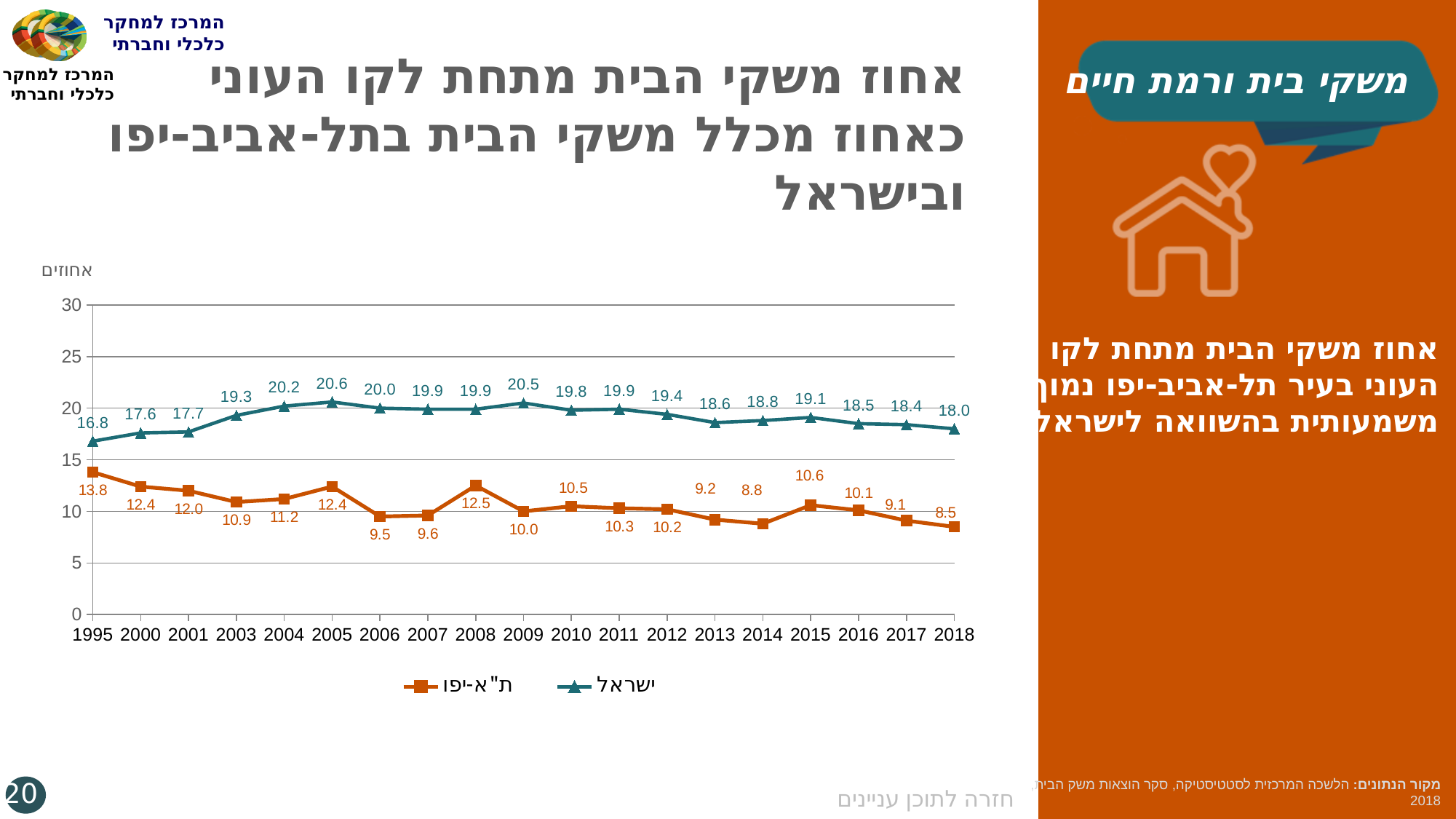
What is the difference between the ישראל and ת"א-יפו values in 2018? 9.5 In which year is the ת"א-יפו series at its lowest? 2018 Is the value for ת"א-יפו in 2014 greater or less than 10? less Which series has the higher value in 2008, ישראל or ת"א-יפו? ישראל What is the value for ישראל in 2005? 20.6 How many series does the legend list? 2 In which year is the ישראל series at its highest? 2005 Does the ת"א-יפו series rise or fall overall from 1995 to 2018? fall What is the value for ת"א-יפו in 2018? 8.5 How many years are plotted along the x axis? 19 What is the value for ת"א-יפו in 1995? 13.8 What type of chart is shown on the slide? line chart